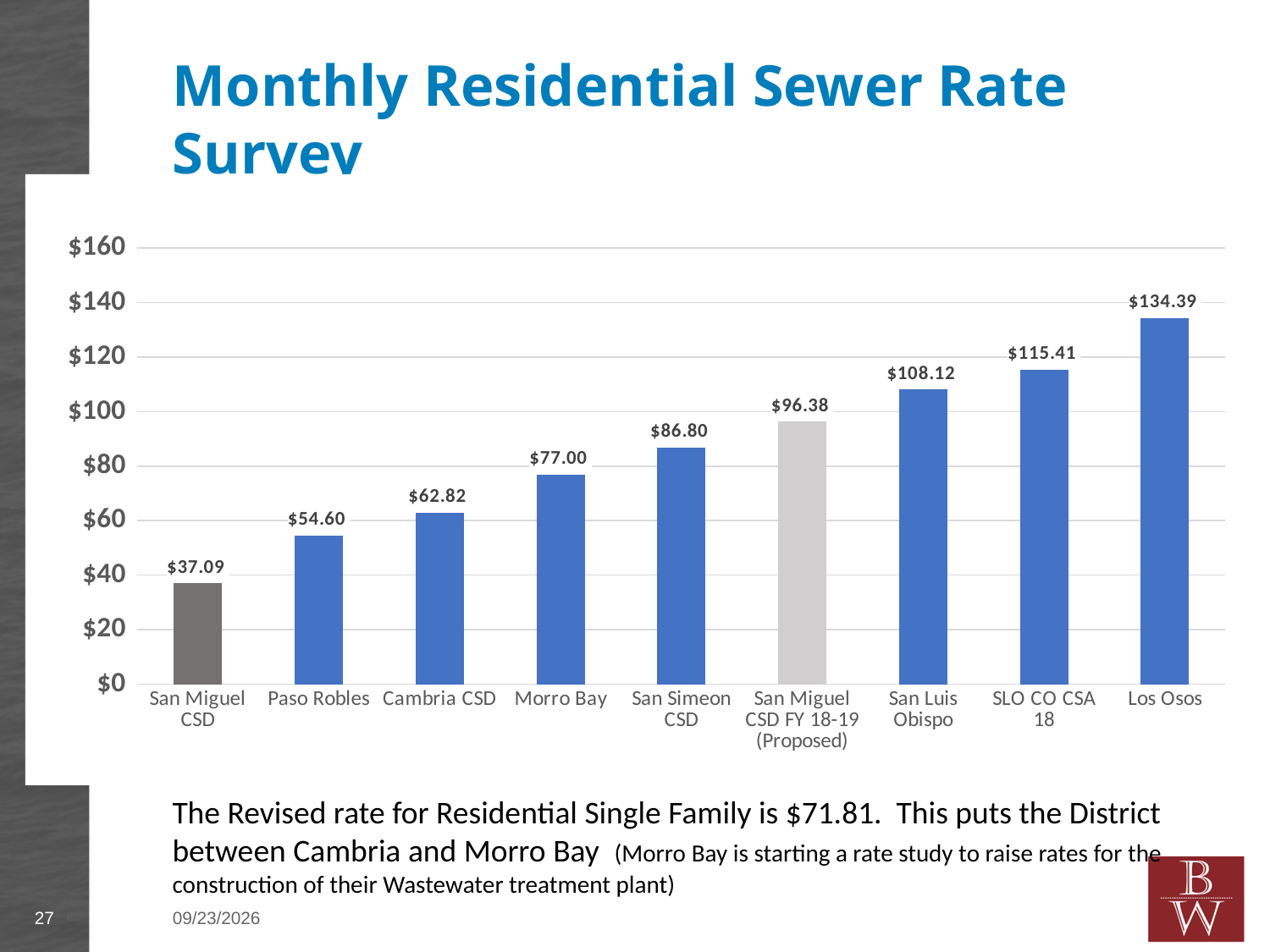
Do the values rise or fall moving from left to right along the x axis? rise What is the monthly residential sewer rate shown for Paso Robles? $54.60 How many categories are shown on the chart? 9 What is the difference between the Los Osos rate and the San Miguel CSD rate? $97.30 Which category has the lowest monthly sewer rate on the chart? San Miguel CSD Which category has the highest monthly sewer rate on the chart? Los Osos Which is larger, the rate for San Luis Obispo or the rate for San Simeon CSD? San Luis Obispo What is the value shown for San Miguel CSD FY 18-19 (Proposed)? $96.38 What is the difference between the Morro Bay rate and the Cambria CSD rate? $14.18 What is the value shown for SLO CO CSA 18? $115.41 Is the value for Morro Bay greater or less than $80? less What kind of chart is shown on the slide? bar chart